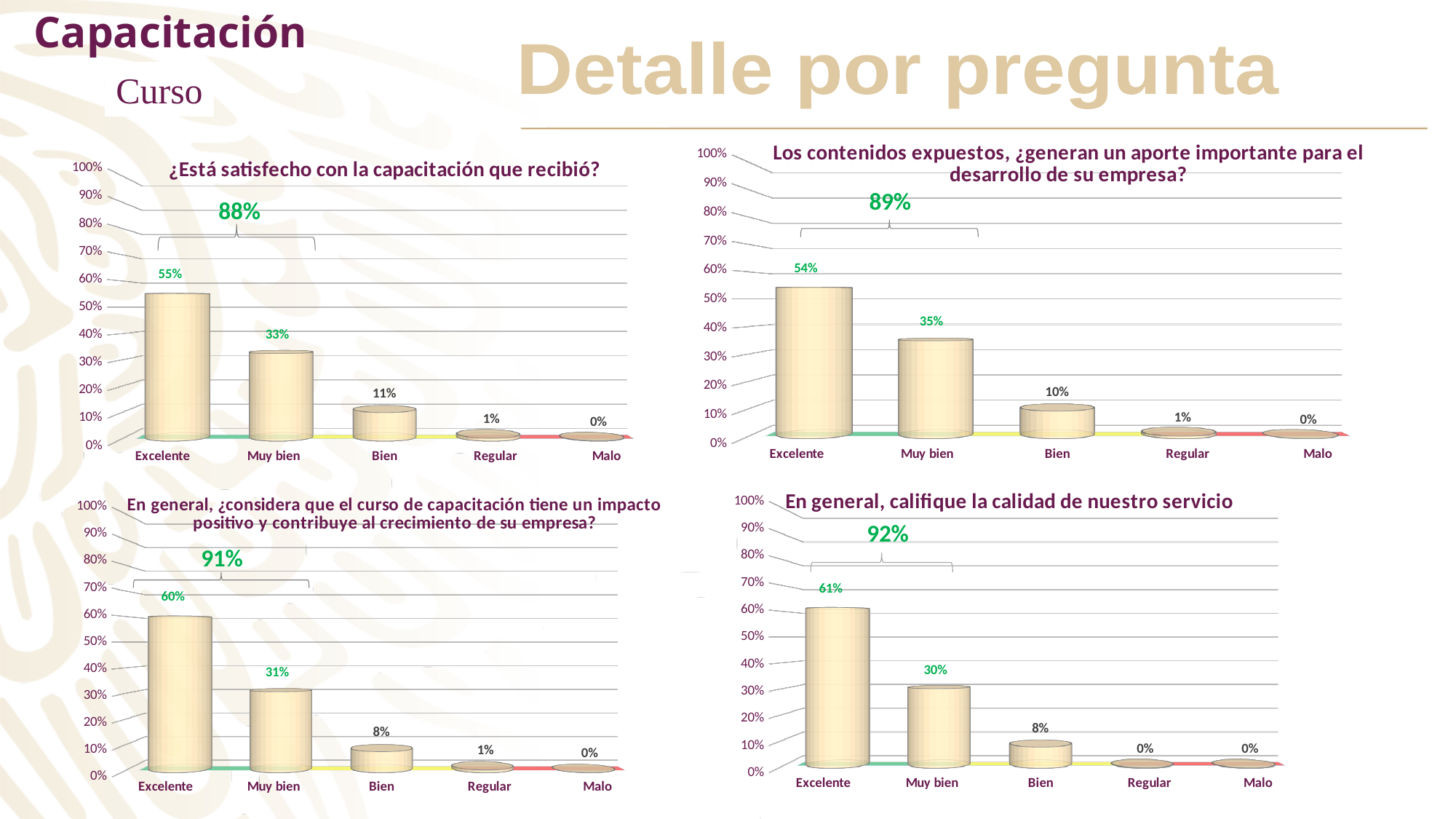
In the top-left chart (¿Está satisfecho con la capacitación que recibió?), do the values rise or fall from Excelente to Malo? Fall What kind of chart is the bottom-right chart (En general, califique la calidad de nuestro servicio)? Bar chart What combined percentage is shown above the bracket over Excelente and Muy bien in the bottom-right chart (En general, califique la calidad de nuestro servicio)? 92% How many categories are shown on the x axis of the top-left chart (¿Está satisfecho con la capacitación que recibió?)? 5 In the bottom-right chart (En general, califique la calidad de nuestro servicio), which is larger, Muy bien or Bien? Muy bien In the top-right chart (Los contenidos expuestos, ¿generan un aporte importante para el desarrollo de su empresa?), what is the value for Muy bien? 35% In the bottom-left chart (En general, ¿considera que el curso de capacitación tiene un impacto positivo...?), what is the value for Bien? 8% In the bottom-left chart (En general, ¿considera que el curso de capacitación tiene un impacto positivo...?), which category has the lowest value? Malo In the top-left chart (¿Está satisfecho con la capacitación que recibió?), which category has the highest value? Excelente In the top-right chart (Los contenidos expuestos, ¿generan un aporte importante para el desarrollo de su empresa?), what is the difference between Excelente and Muy bien? 19% In the top-left chart (¿Está satisfecho con la capacitación que recibió?), what is the value for Excelente? 55% In the bottom-right chart (En general, califique la calidad de nuestro servicio), what is the value for Excelente? 61%